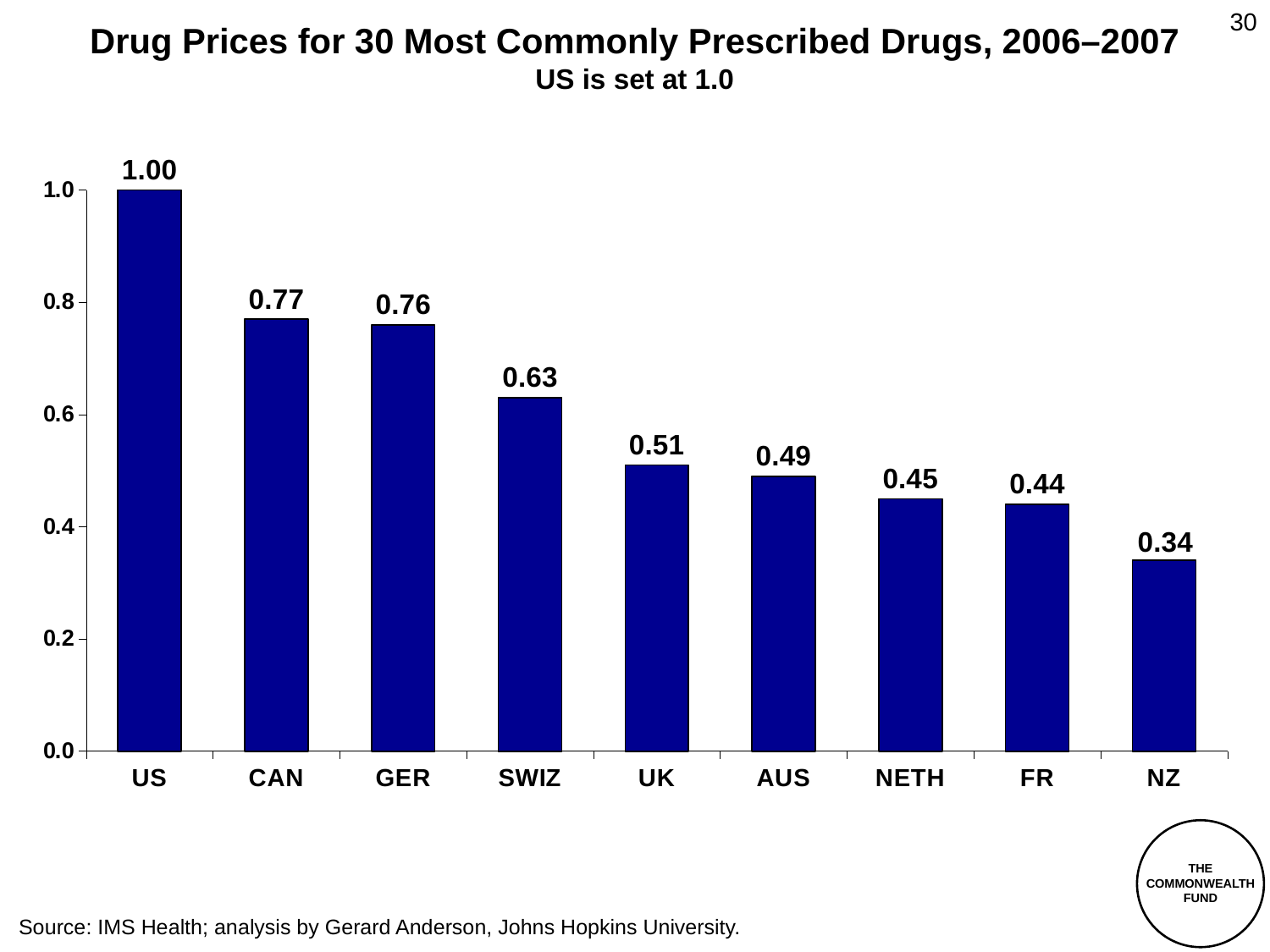
Do the values rise or fall from left to right along the x axis? fall What is the difference between the values for GER and UK? 0.25 What is the value for SWIZ? 0.63 Which is larger, the value for SWIZ or the value for AUS? SWIZ Which country has the highest value? US What is the difference between the values for US and NZ? 0.66 Is the value for FR greater or less than 0.6? less What is the value for CAN? 0.77 How many countries are shown on the chart? 9 What kind of chart is shown on the slide? bar chart What is the value for NETH? 0.45 Which country has the lowest value? NZ